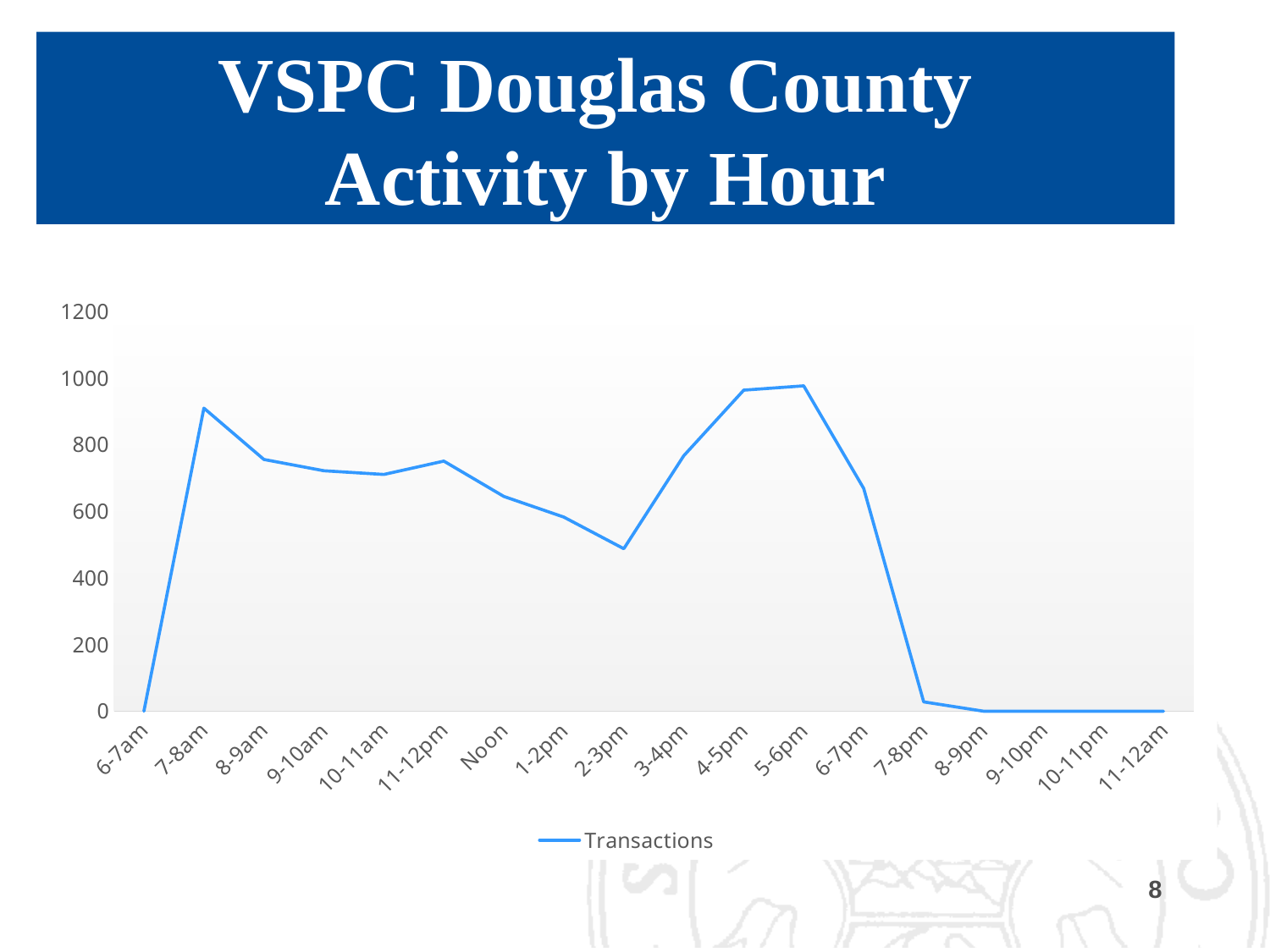
Is the value for 7-8pm greater or less than 200? less Is the value for 6-7pm greater or less than 400? greater Do the values rise or fall from 2-3pm to 5-6pm? rise Which is larger, the value for 7-8am or the value for 8-9am? 7-8am What is the name of the series shown in the legend? Transactions Is the value for 2-3pm greater or less than 600? less How many hourly categories are shown on the x axis? 18 Do the values rise or fall from 11-12pm to 2-3pm? fall Which is larger, the value for 2-3pm or the value for 3-4pm? 3-4pm What kind of chart is shown on the slide? Line chart How many series does the legend list? 1